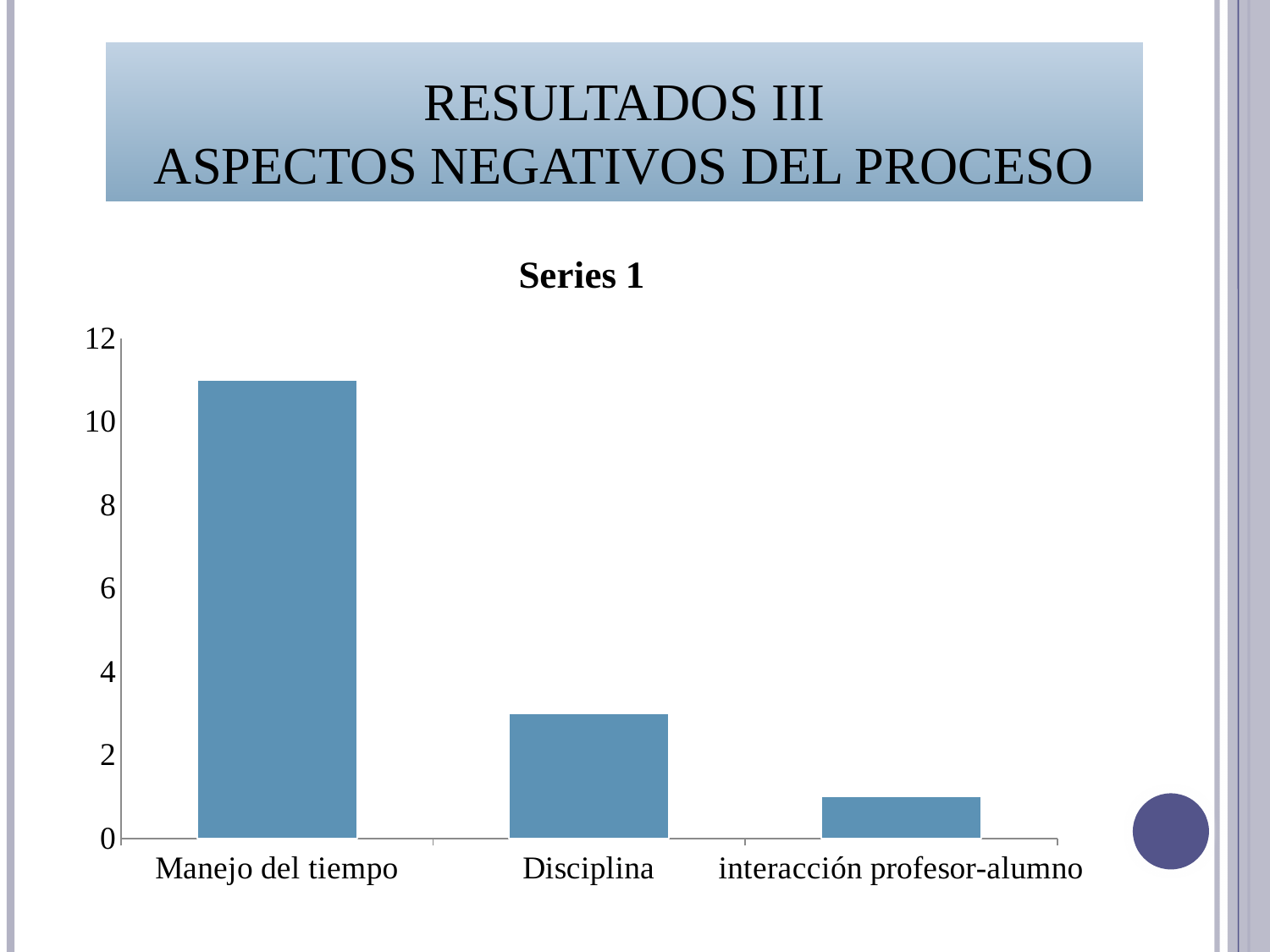
Which is larger, the value for Disciplina or the value for interacción profesor-alumno? Disciplina Is the value for Disciplina greater or less than 4? less Is the value for Disciplina greater or less than 2? greater Is the value for Manejo del tiempo greater or less than 12? less What kind of chart is shown on the slide? bar chart How many categories are shown on the x axis of the chart? 3 Which category has the lowest bar in the chart? interacción profesor-alumno What is the title shown above the chart? Series 1 Which category has the highest bar in the chart? Manejo del tiempo Do the bar values rise or fall from left to right along the x axis? fall